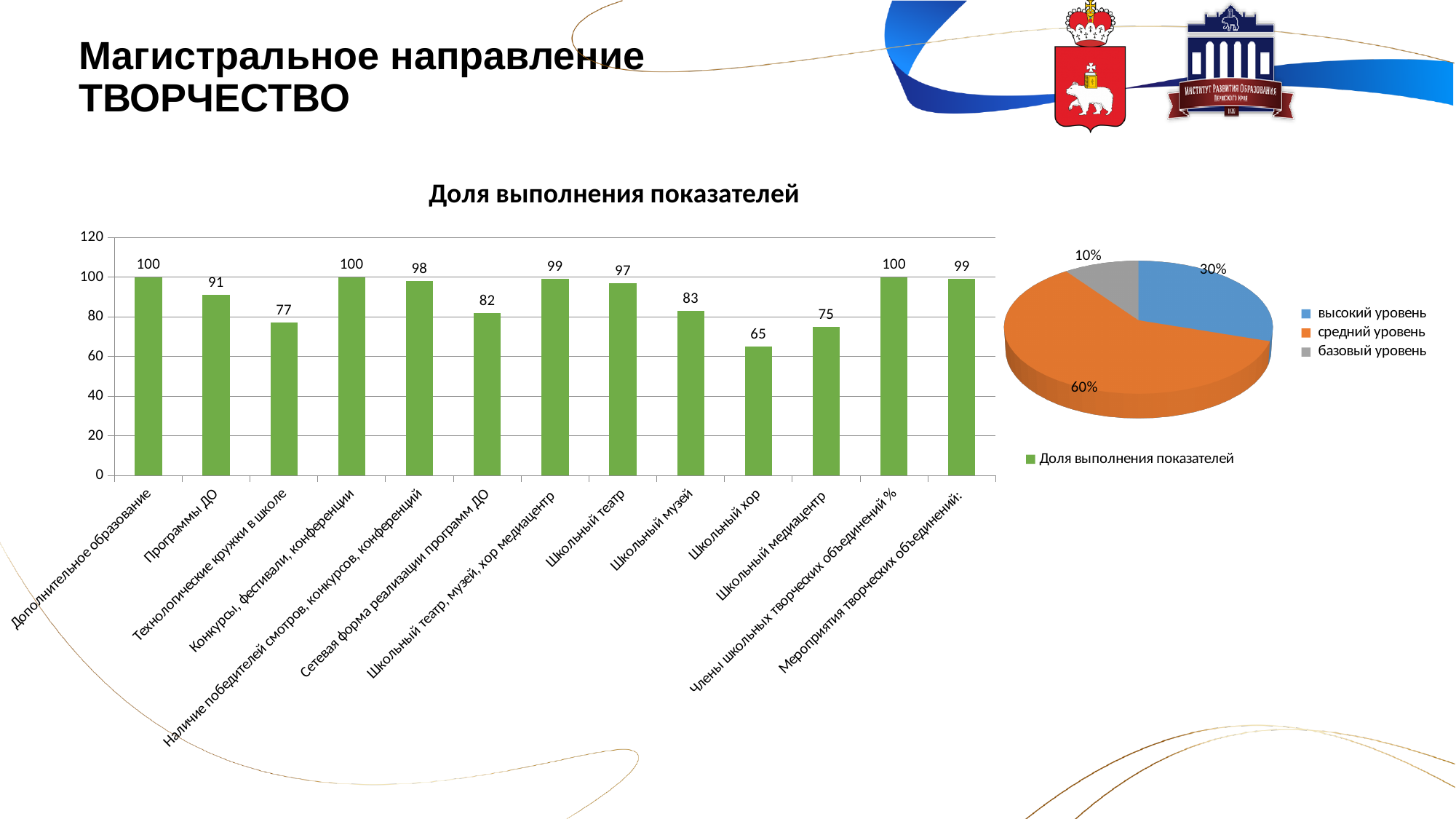
In the pie chart on the right, what share does средний уровень have? 60% In the bar chart "Доля выполнения показателей", which is larger: the value for Программы ДО or the value for Технологические кружки в школе? Программы ДО In the bar chart "Доля выполнения показателей", what is the value for Школьный хор? 65 In the bar chart "Доля выполнения показателей", what is the value for Школьный медиацентр? 75 How many entries does the legend of the pie chart on the right list? 3 What type of chart is the chart on the left of the slide? Bar chart In the bar chart "Доля выполнения показателей", what is the value for Сетевая форма реализации программ ДО? 82 In the pie chart on the right, what share does базовый уровень have? 10% In the bar chart "Доля выполнения показателей", what is the difference between the values for Школьный музей and Школьный хор? 18 How many categories are shown in the bar chart "Доля выполнения показателей"? 13 In the pie chart on the right, which level has the largest share? средний уровень In the bar chart "Доля выполнения показателей", which category has the lowest value? Школьный хор